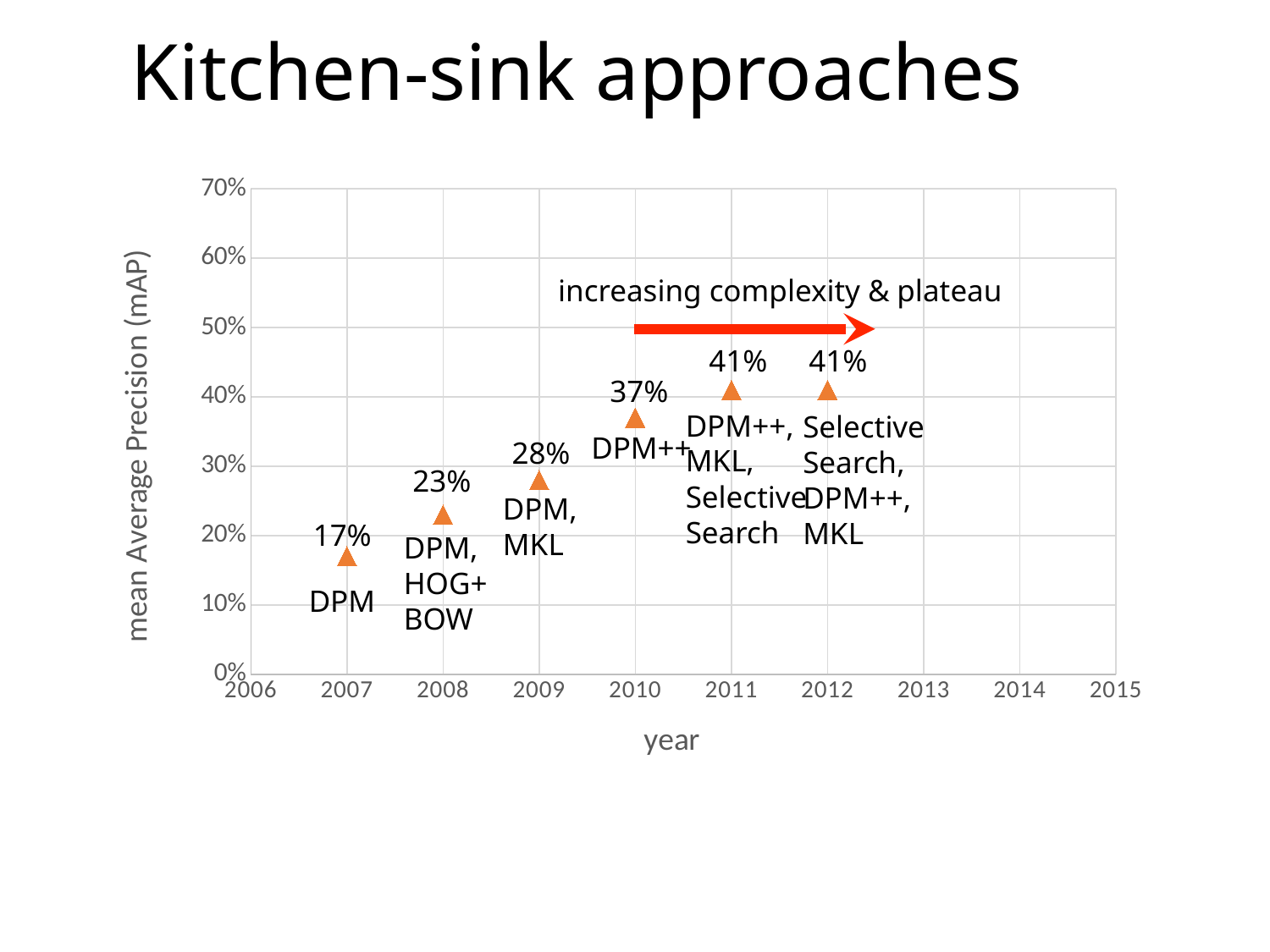
What is the mAP value plotted for 2010? 37% What is the difference between the mAP values for 2011 and 2007? 24% What is the mAP value plotted for 2009? 28% Is the mAP value for 2012 greater or less than 50%? less What is the difference between the mAP values for 2010 and 2008? 14% How many data points are plotted on the chart? 6 What kind of chart is shown on the slide? scatter chart Which year has the lowest plotted mAP value? 2007 Do the plotted mAP values generally rise or fall from 2007 to 2012? rise What is the label on the y axis of the chart? mean Average Precision (mAP) What is the mean Average Precision (mAP) value plotted for 2007? 17% Which is larger, the mAP value for 2009 or for 2010? 2010